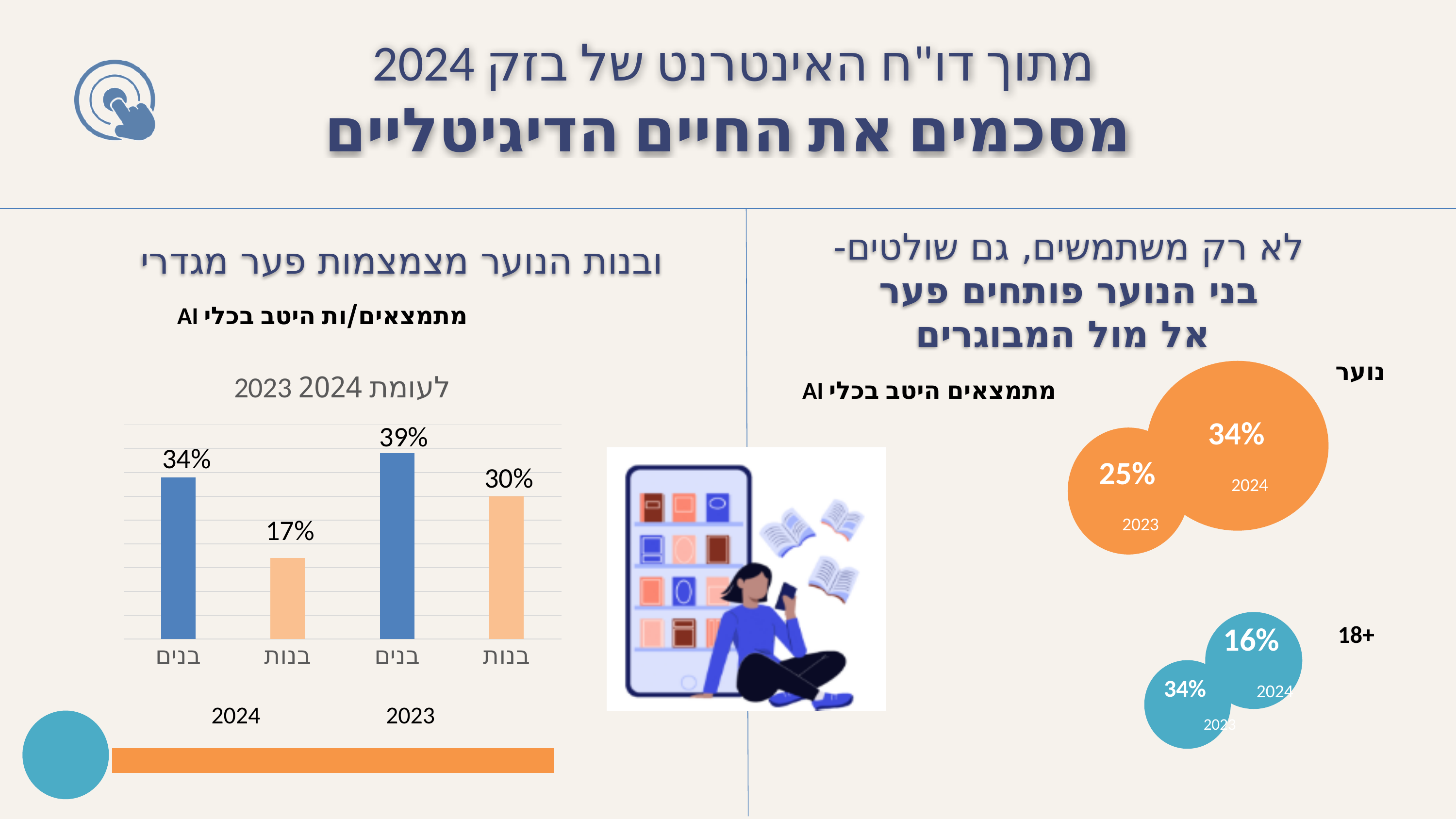
In the bar chart on the left, what colour are the בנים bars? Blue In the bar chart on the left, by how much did the value for בנות drop from 2023 to 2024? 13% What kind of chart is shown on the left side of the slide? Bar chart In the bar chart on the left, what is the value for בנים in 2023? 39% How many bars are plotted in the bar chart on the left? 4 In the bar chart on the left, which is larger: בנים in 2024 or בנות in 2023? בנים in 2024 In the bar chart on the left, what is the value for בנות in 2024? 17% In the bar chart on the left, which bar has the highest value? בנים 2023 In the bar chart on the left, what is the value for בנות in 2023? 30% In the bar chart on the left, what is the difference between בנים and בנות in 2024? 17% In the bar chart on the left, what is the value for בנים in 2024? 34% In the bar chart on the left, which bar has the lowest value? בנות 2024